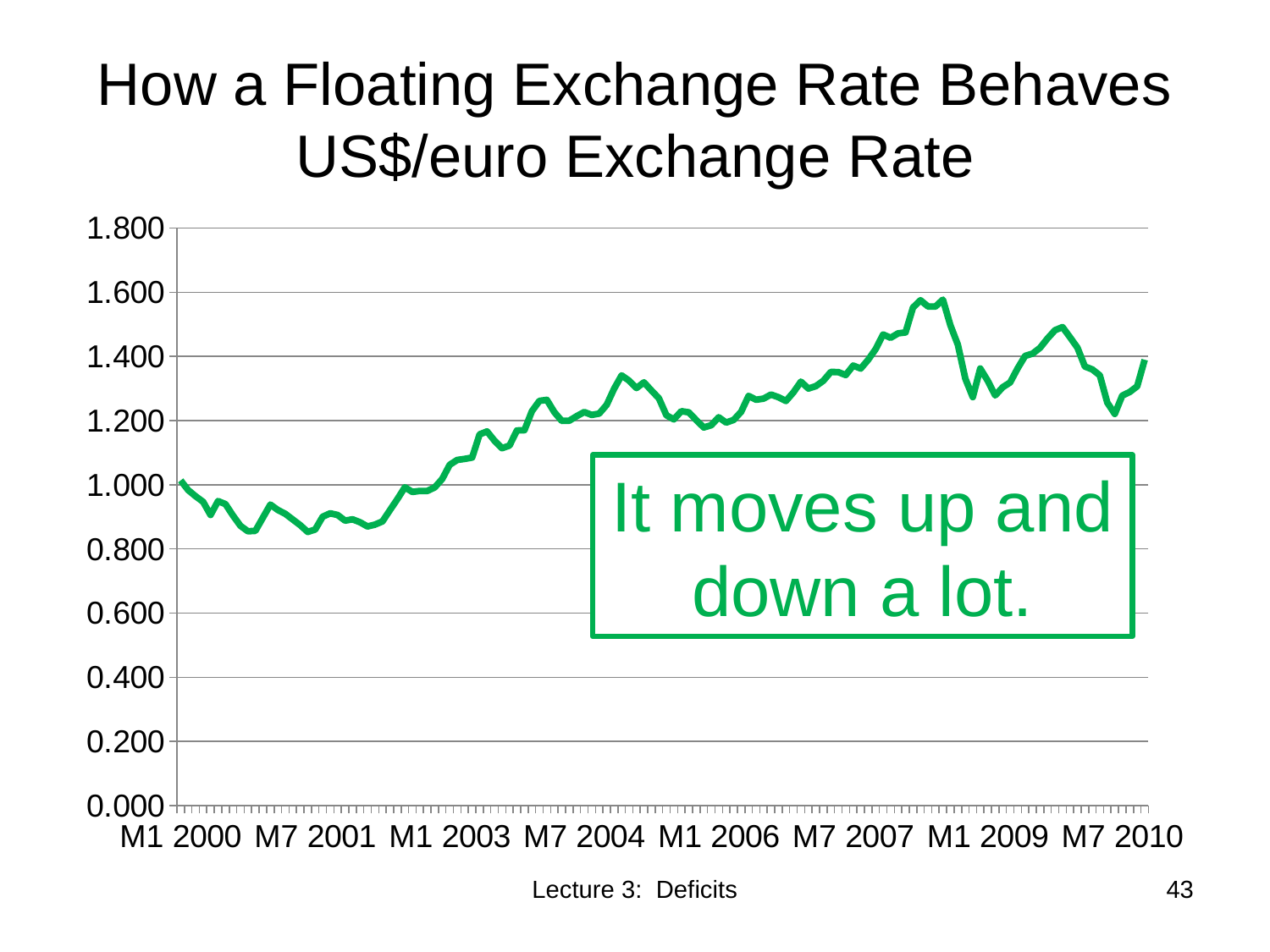
What kind of chart is shown on the slide? line chart What is the title of the chart on the slide? How a Floating Exchange Rate Behaves US$/euro Exchange Rate Is the exchange rate at M7 2007 higher or lower than at M7 2001? higher Is the value of the exchange rate at M7 2001 greater or less than 1.000? less Is the value of the exchange rate at M7 2007 greater or less than 1.200? greater Is the lowest point reached by the line greater or less than 1.000? less Overall, does the exchange rate rise or fall from M1 2000 to M7 2010? rise What does the green text box on the chart say? It moves up and down a lot. Does the exchange rate rise or fall between M1 2000 and M7 2001? fall